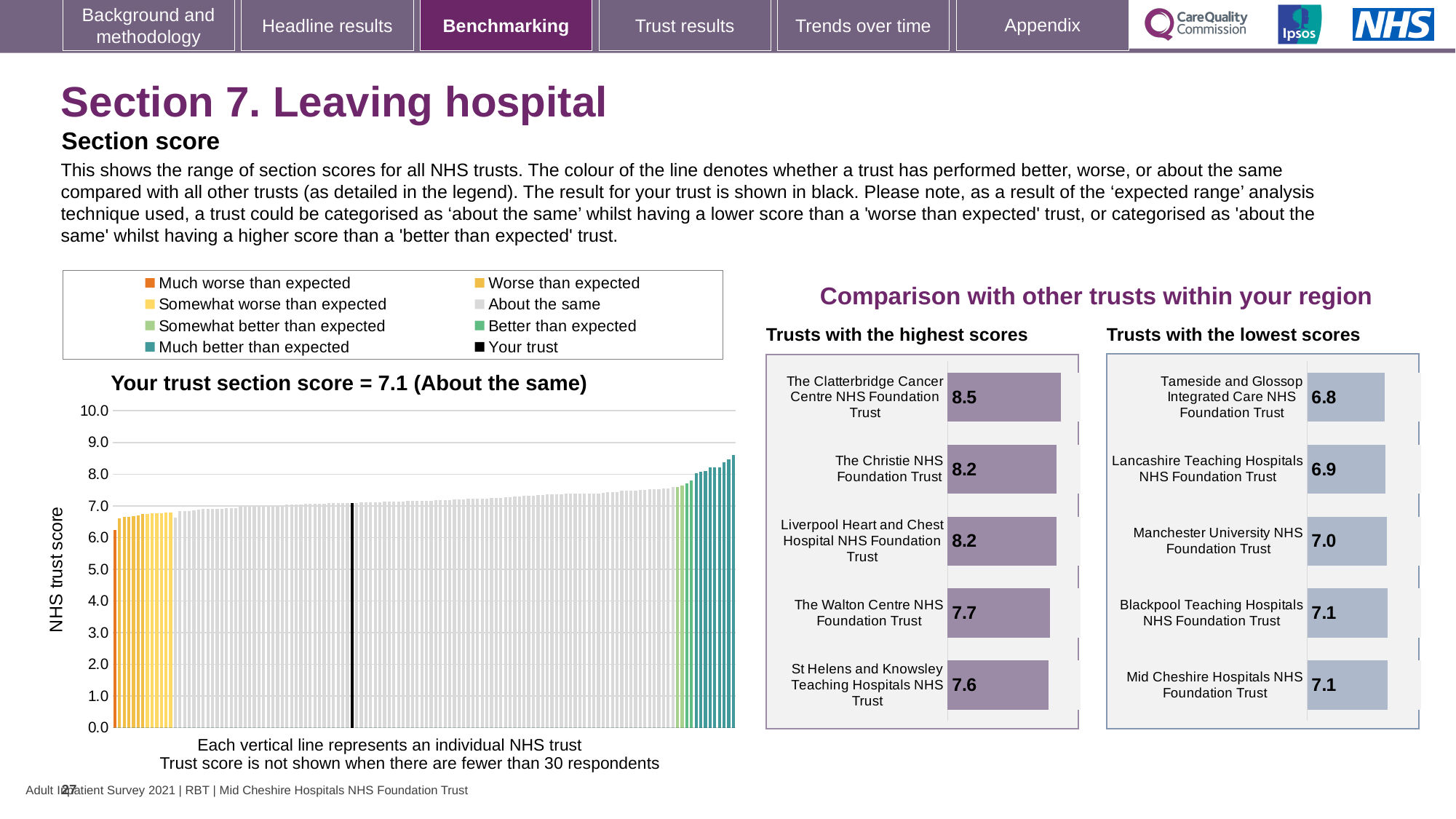
In the 'Trusts with the lowest scores' chart, what is the difference between the scores of Mid Cheshire Hospitals NHS Foundation Trust and Tameside and Glossop Integrated Care NHS Foundation Trust? 0.3 In the 'Your trust section score' chart on the left, what is the section score for your trust? 7.1 What kind of chart is the 'Your trust section score' chart on the left? Bar chart In the 'Trusts with the highest scores' chart, what is the score for The Clatterbridge Cancer Centre NHS Foundation Trust? 8.5 In the 'Trusts with the lowest scores' chart, which trust has the lowest score? Tameside and Glossop Integrated Care NHS Foundation Trust How many entries does the legend above the 'Your trust section score' chart list? 8 In the 'Trusts with the highest scores' chart, which trust has the lowest score? St Helens and Knowsley Teaching Hospitals NHS Trust In the 'Trusts with the highest scores' chart, what is the difference between the scores of The Clatterbridge Cancer Centre NHS Foundation Trust and St Helens and Knowsley Teaching Hospitals NHS Trust? 0.9 In the 'Trusts with the lowest scores' chart, which has the higher score: Lancashire Teaching Hospitals NHS Foundation Trust or Manchester University NHS Foundation Trust? Manchester University NHS Foundation Trust In the 'Trusts with the lowest scores' chart, what is the score for Tameside and Glossop Integrated Care NHS Foundation Trust? 6.8 In the 'Your trust section score' chart on the left, do the trust scores rise or fall from left to right along the x axis? Rise In the 'Trusts with the highest scores' chart, how many trusts are shown? 5